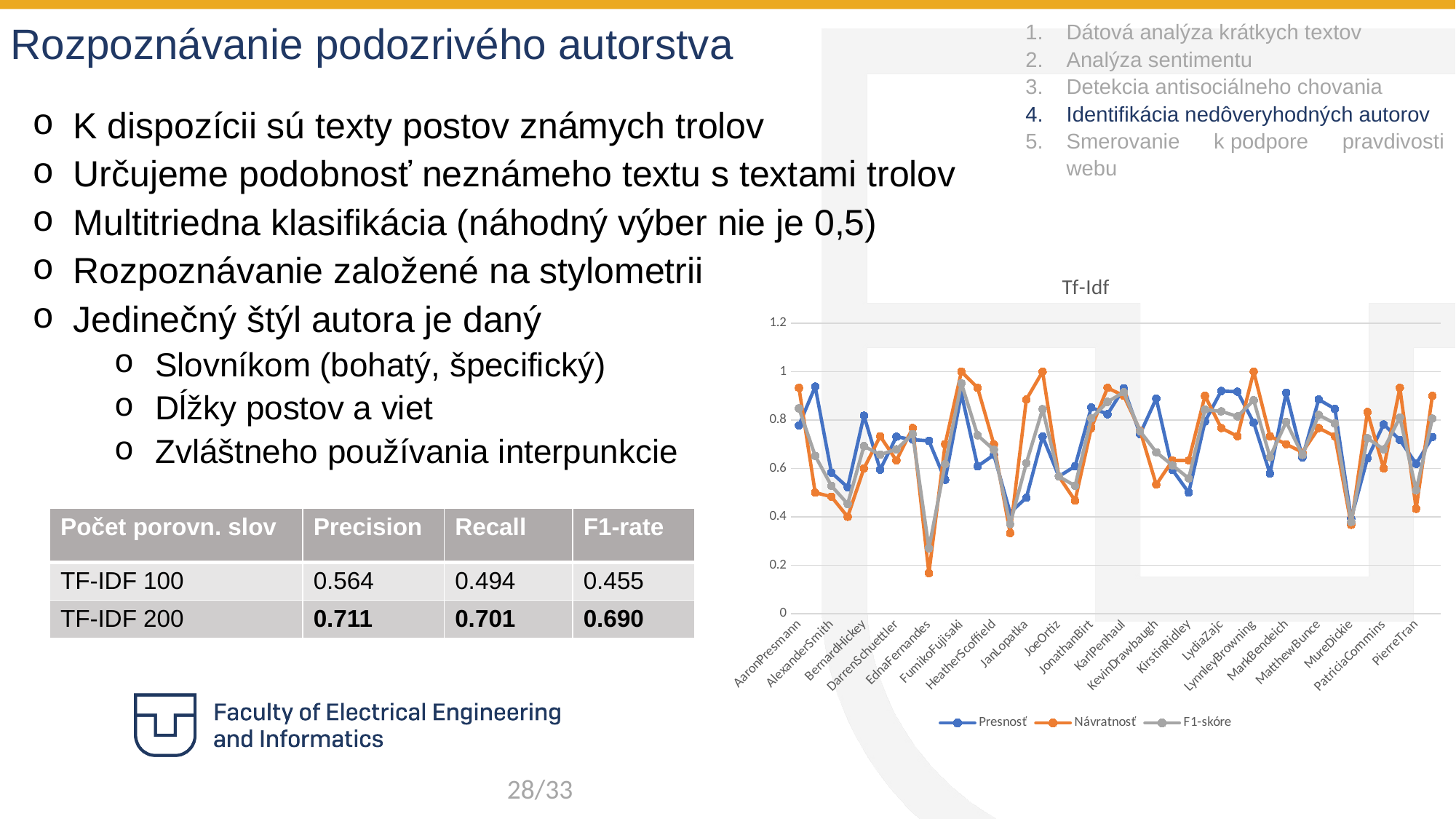
In the Tf-Idf chart, which is larger for AaronPresmann: Presnosť or Návratnosť? Návratnosť What kind of chart is the Tf-Idf chart? line chart In the Tf-Idf chart, is the Návratnosť value for AaronPresmann greater or less than 0.8? greater In the Tf-Idf chart, is the Presnosť value for PierreTran greater or less than 0.8? less Which series are listed in the legend of the Tf-Idf chart? Presnosť, Návratnosť, F1-skóre In the Tf-Idf chart, is the Návratnosť value for PierreTran greater or less than 0.8? less In the Tf-Idf chart, which is larger for PierreTran: Presnosť or Návratnosť? Presnosť How many series does the legend of the Tf-Idf chart list? 3 What is the title of the chart on the slide? Tf-Idf